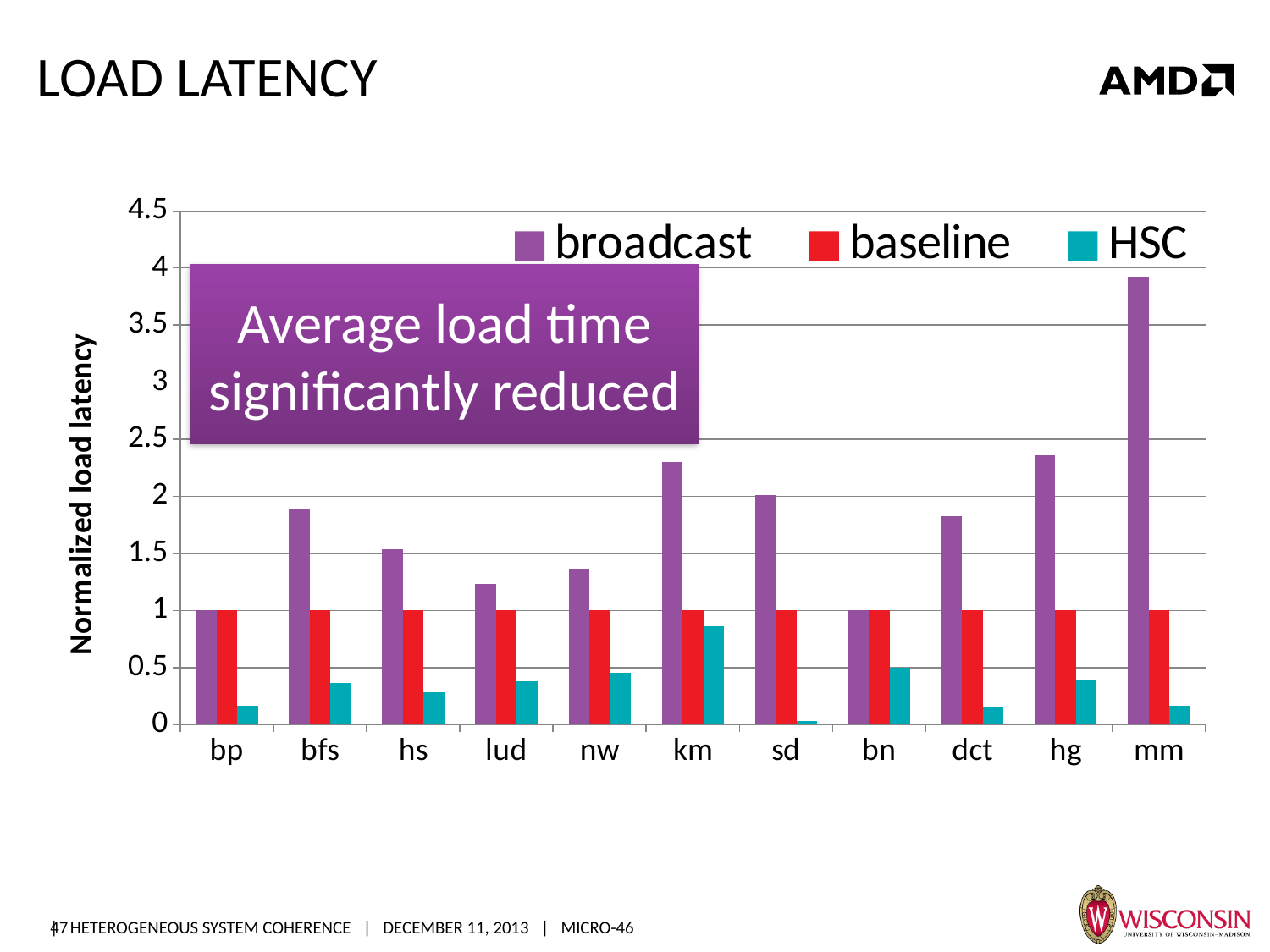
What kind of chart is shown on the slide? bar chart What is the baseline value for bp? 1 Which category has the highest broadcast value? mm Which is larger, the broadcast value for bfs or for hs? bfs How many categories (benchmarks) are shown on the x axis? 11 Which category has the lowest HSC value? sd Is the broadcast value for hs greater or less than 2? less What is the title of the y axis? Normalized load latency How many series does the legend list? 3 Is the HSC value for km greater or less than 0.5? greater Is the broadcast value for mm greater or less than 3.5? greater Which category has the highest HSC value? km